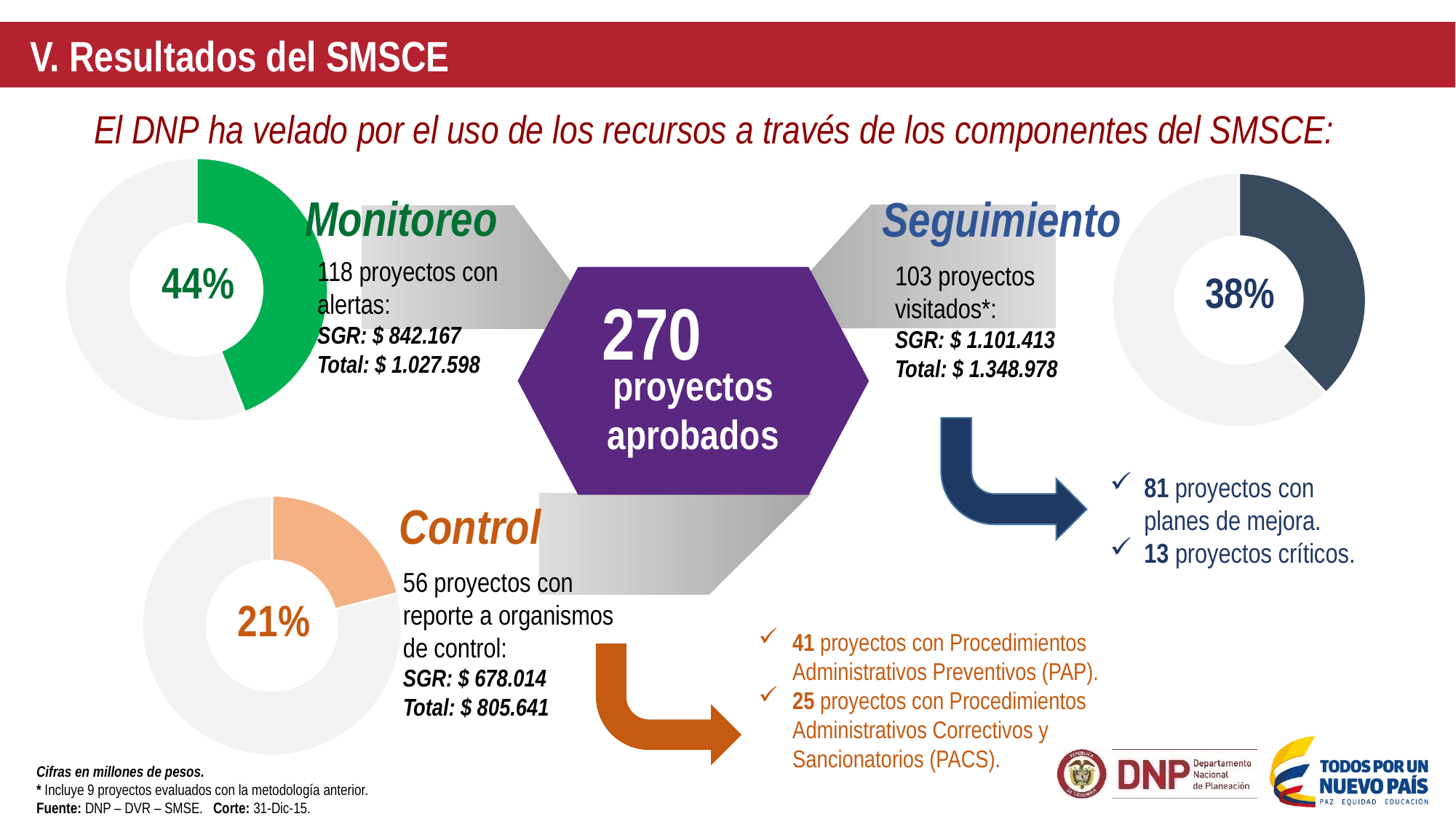
What kind of chart is used to show the 44%, 38% and 21% values on the slide? Donut (pie) chart What is the difference in percentage points between the Monitoreo donut (44%) and the Seguimiento donut (38%)? 6 percentage points What percentage is shown in the centre of the Control donut chart (bottom left)? 21% What percentage is shown in the centre of the Monitoreo donut chart (top left)? 44% Which donut chart shows a larger percentage, Seguimiento or Control? Seguimiento Which of the three donut charts (Monitoreo, Seguimiento, Control) shows the highest percentage? Monitoreo What colour is the filled segment of the Monitoreo donut chart? Green Which of the three donut charts (Monitoreo, Seguimiento, Control) shows the lowest percentage? Control Which donut chart shows a larger percentage, Monitoreo or Seguimiento? Monitoreo How many donut charts are shown on the slide? 3 What is the difference in percentage points between the Monitoreo donut (44%) and the Control donut (21%)? 23 percentage points What percentage is shown in the centre of the Seguimiento donut chart (top right)? 38%